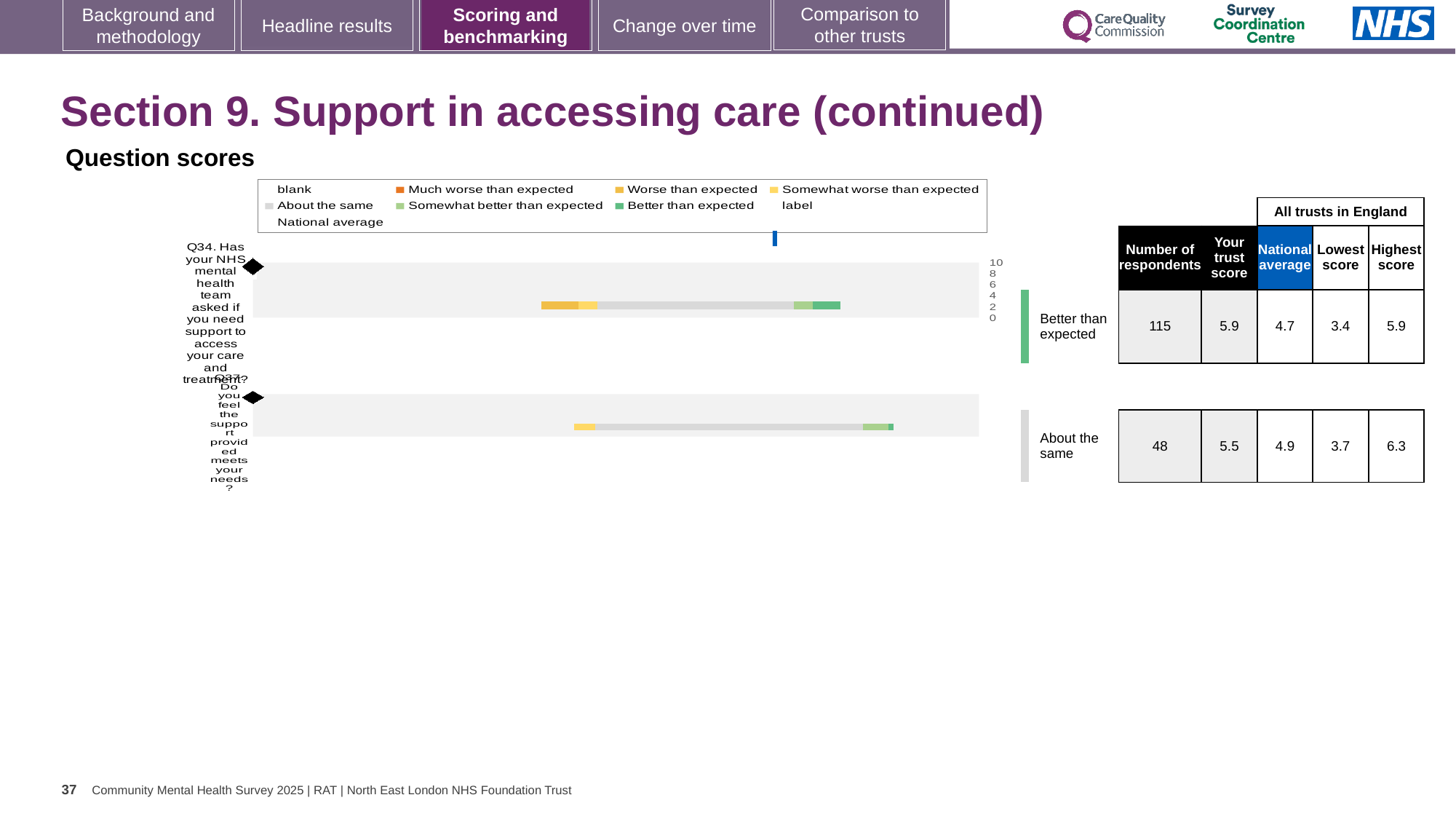
What kind of chart is used to show the question scores on this slide? bar chart How many questions are plotted in the question scores chart? 2 What is the highest score among all trusts in England for Q37? 6.3 What benchmark category is shown for Q37? About the same What is the national average score for Q34? 4.7 How many respondents answered Q37? 48 Which question has the higher trust score, Q34 or Q37? Q34 Which question has the larger number of respondents? Q34 What is the difference between the trust score and the national average for Q34? 1.2 What benchmark category is shown for Q34? Better than expected What is the 'Your trust score' for Q34 (Has your NHS mental health team asked if you need support to access your care and treatment)? 5.9 What is the 'Your trust score' for Q37 (Do you feel the support provided meets your needs)? 5.5